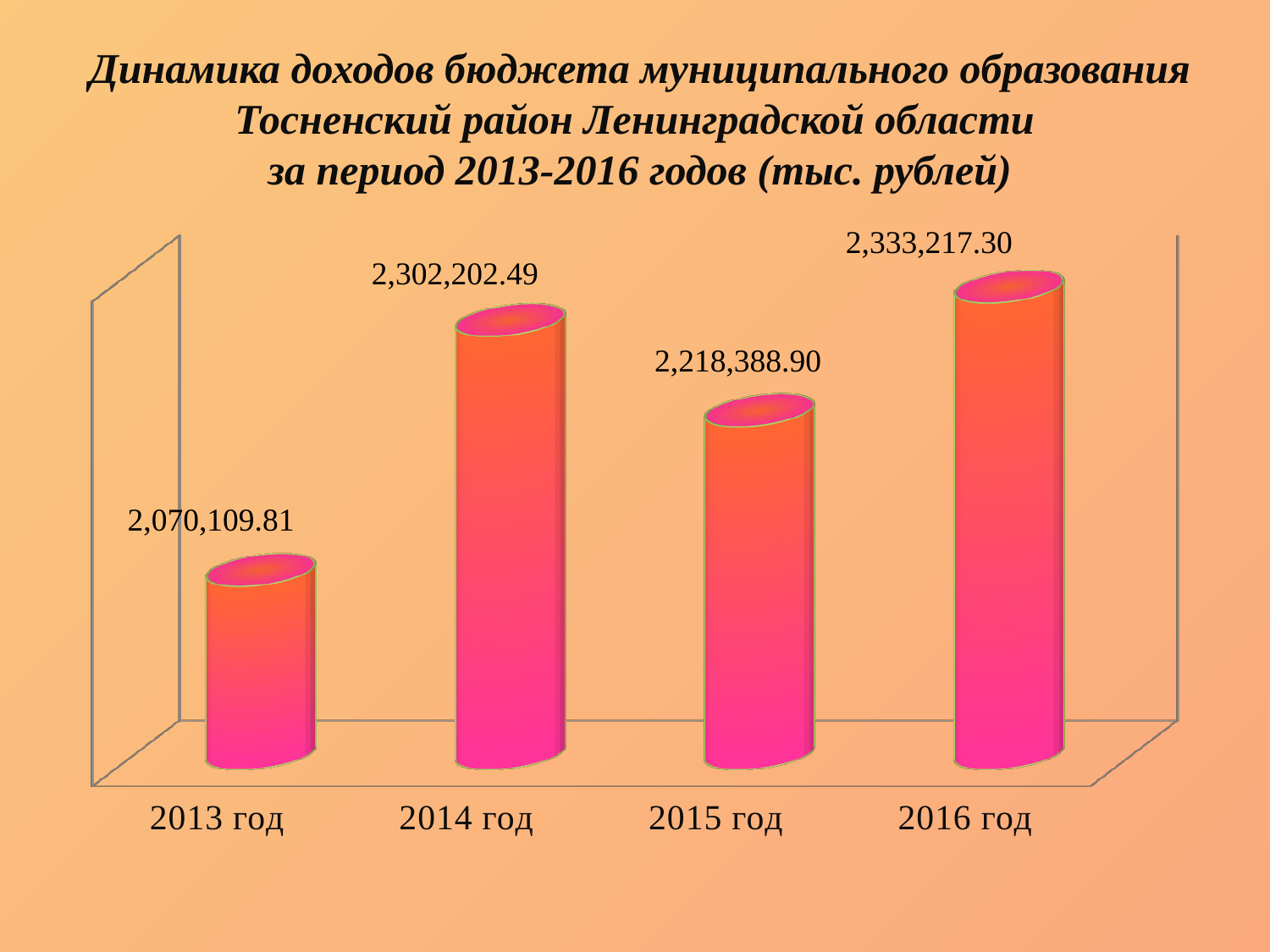
Which year has the lowest value? 2013 год Does the value rise or fall from 2014 год to 2015 год? Fall How many years are shown on the chart? 4 What kind of chart is shown on the slide? Bar chart Which is larger, the value for 2014 год or the value for 2015 год? 2014 год What is the value for 2013 год? 2,070,109.81 What is the value for 2015 год? 2,218,388.90 What is the value for 2014 год? 2,302,202.49 What is the value for 2016 год? 2,333,217.30 What is the difference between the values for 2014 год and 2015 год? 83,813.59 What is the difference between the values for 2016 год and 2013 год? 263,107.49 Which year has the highest value? 2016 год